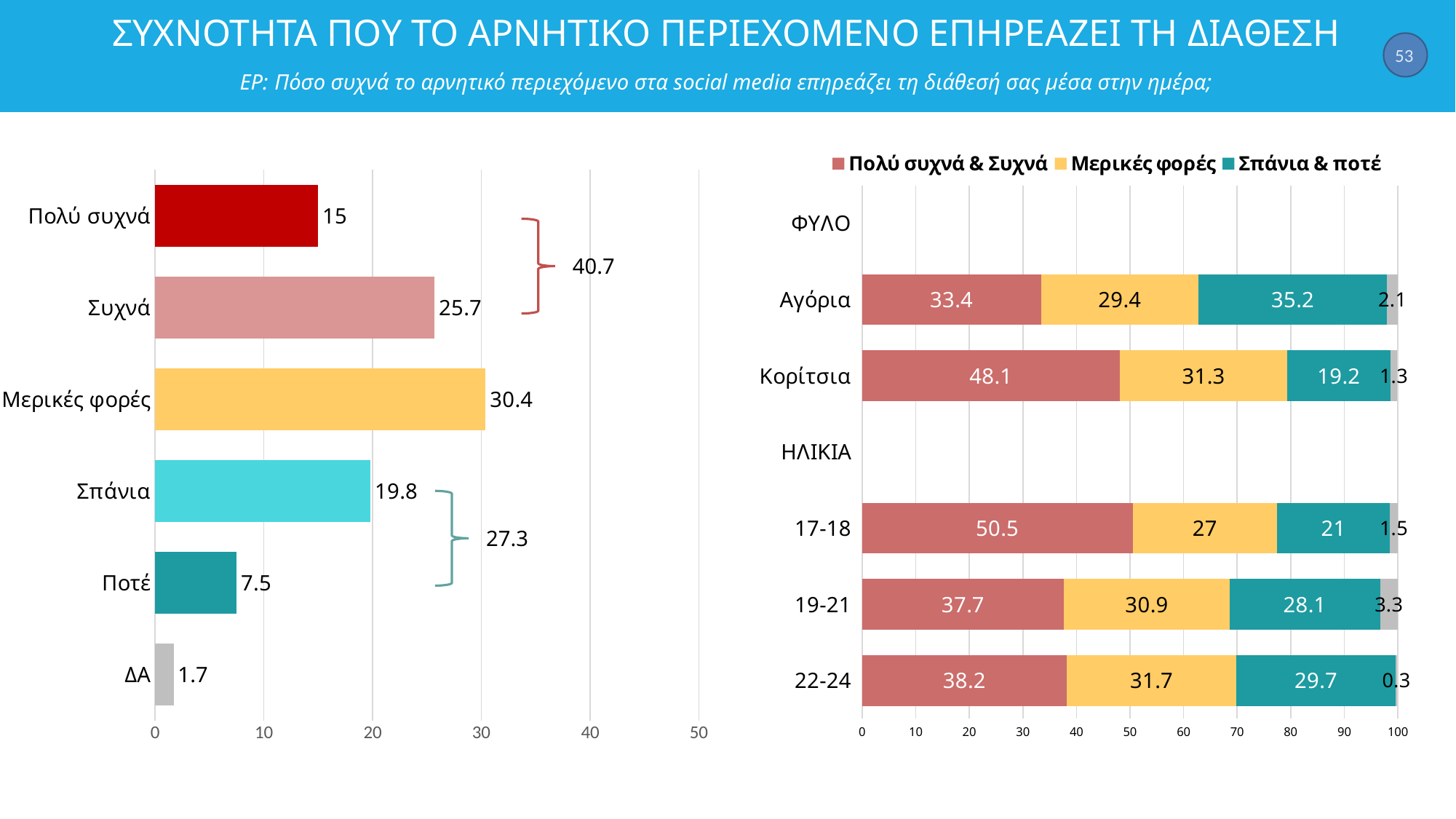
In the right stacked bar chart, which group has the highest value for Πολύ συχνά & Συχνά? 17-18 In the right stacked bar chart, what is the value of Πολύ συχνά & Συχνά for Κορίτσια? 48.1 In the left bar chart, how many categories are shown? 6 In the right stacked bar chart, which is larger: the Σπάνια & ποτέ value for Αγόρια or for Κορίτσια? Αγόρια In the left bar chart, what is the difference between the values for Συχνά and Πολύ συχνά? 10.7 In the right stacked bar chart, what is the difference between the Μερικές φορές values for 22-24 and 17-18? 4.7 In the left bar chart, which category has the lowest value? ΔΑ What kind of chart is the chart on the left of the slide? Bar chart In the left bar chart, what is the value for Μερικές φορές? 30.4 How many series does the legend of the right stacked bar chart list? 3 In the right stacked bar chart, what is the value of Σπάνια & ποτέ for 19-21? 28.1 In the left bar chart, which category has the highest value? Μερικές φορές